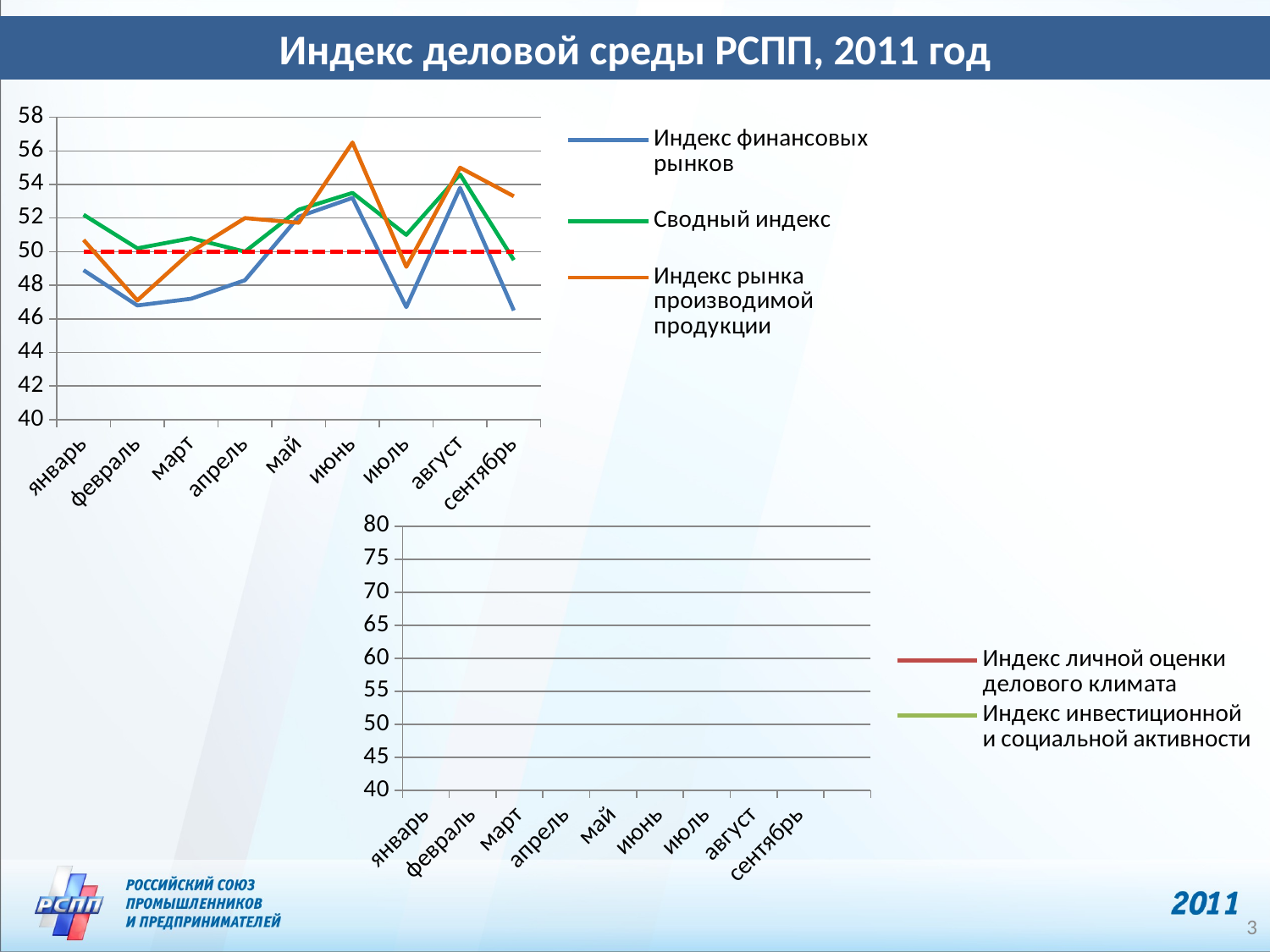
What kind of chart is the top-left chart on the slide? line chart In the top-left chart, is the value of Индекс рынка производимой продукции in июнь greater or less than 54? greater What is the title of the slide containing the charts? Индекс деловой среды РСПП, 2011 год In the top-left chart, in which month does Индекс рынка производимой продукции reach its highest value? июнь How many months are shown on the x axis of the top-left chart? 9 In the top-left chart, is the value of Сводный индекс in январь greater or less than 50? greater In the top-left chart, which is larger in июнь: Индекс рынка производимой продукции or Индекс финансовых рынков? Индекс рынка производимой продукции In the top-left chart, does Индекс финансовых рынков rise or fall from июнь to июль? fall In the top-left chart, in which month is Индекс рынка производимой продукции at its lowest? февраль In the top-left chart, is the value of Индекс финансовых рынков in февраль greater or less than 48? less How many series does the legend of the top-left chart list? 3 How many series does the legend of the bottom-right chart list? 2